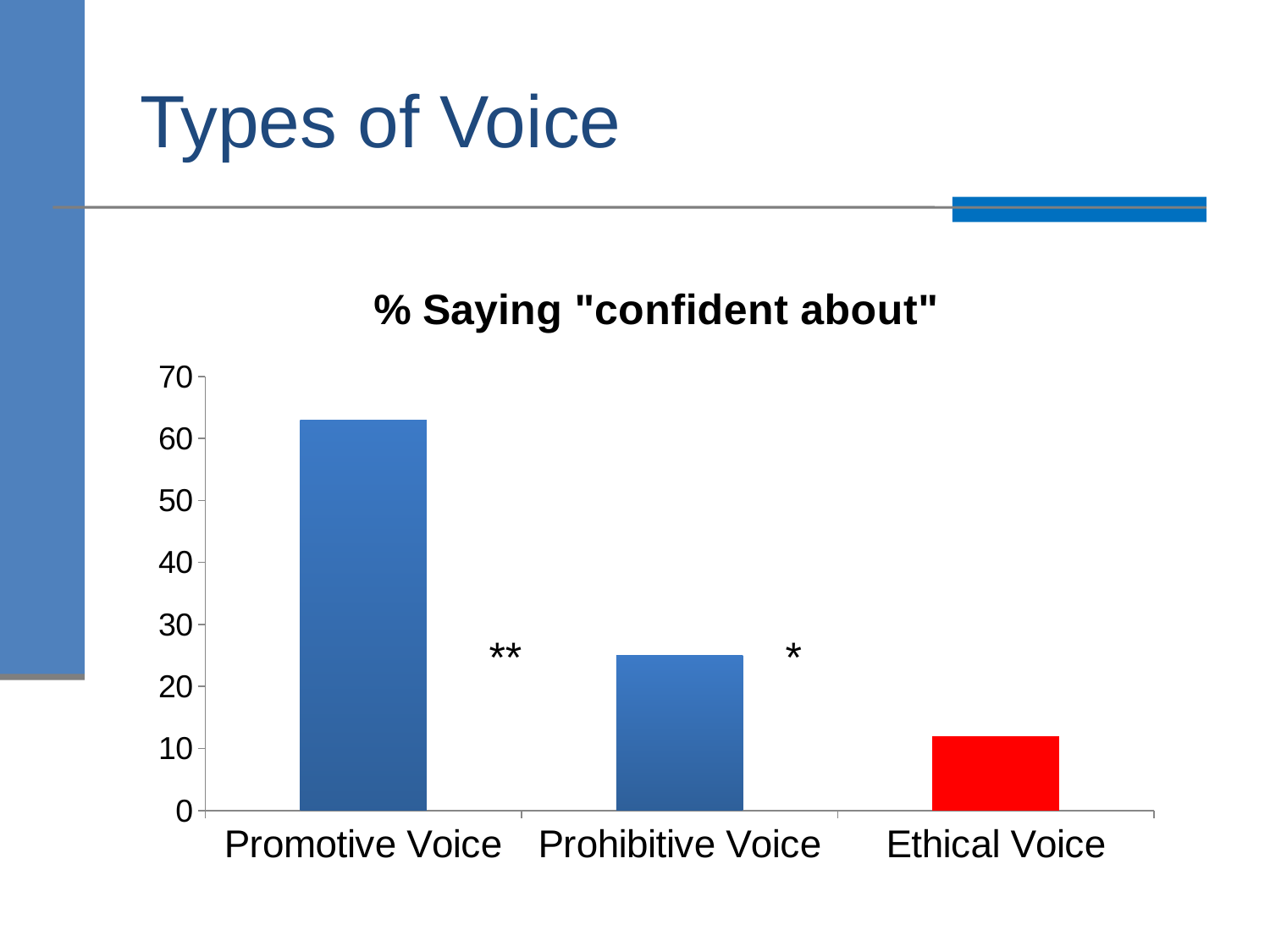
Which is larger, the value for Prohibitive Voice or the value for Ethical Voice? Prohibitive Voice Is the value for Ethical Voice greater or less than 20? less Do the values rise or fall moving from left to right along the x axis? fall Is the value for Prohibitive Voice greater or less than 30? less How many categories are shown on the x axis of the chart? 3 Which type of voice has the highest value in the chart? Promotive Voice Which type of voice has the lowest value in the chart? Ethical Voice What kind of chart is shown on the slide? bar chart What is the title of the chart? % Saying "confident about" Is the value for Promotive Voice greater or less than 60? greater Which bar in the chart is coloured red? Ethical Voice Which is larger, the value for Promotive Voice or the value for Prohibitive Voice? Promotive Voice